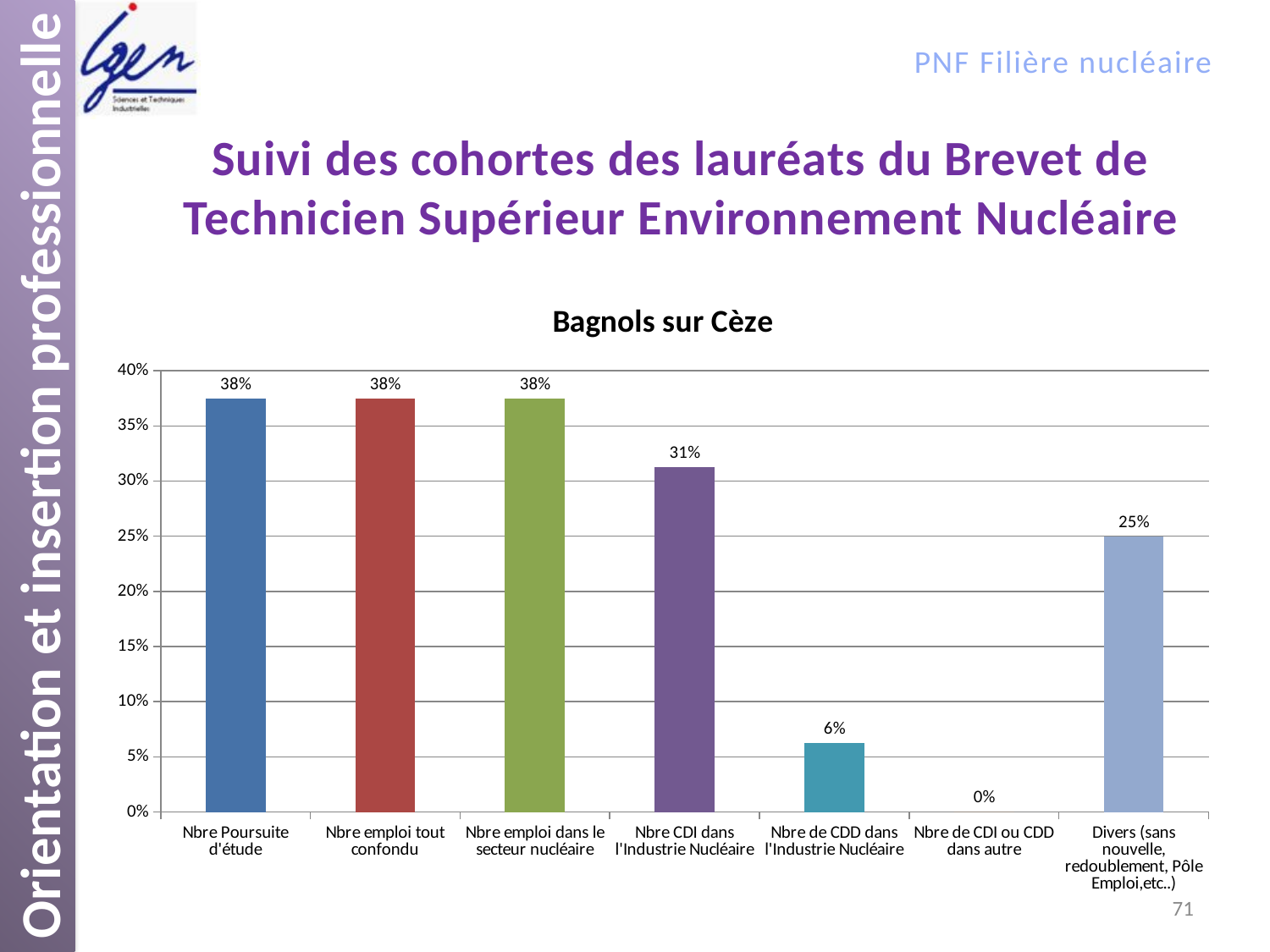
Which category has the lowest value? Nbre de CDI ou CDD dans autre Which is larger: "Nbre CDI dans l'Industrie Nucléaire" or "Divers (sans nouvelle, redoublement, Pôle Emploi,etc..)"? Nbre CDI dans l'Industrie Nucléaire What is the difference between "Divers (sans nouvelle, redoublement, Pôle Emploi,etc..)" and "Nbre de CDD dans l'Industrie Nucléaire"? 19% What is the difference between "Nbre emploi tout confondu" and "Nbre CDI dans l'Industrie Nucléaire"? 7% How many categories are shown on the x axis? 7 What kind of chart is shown? bar chart What is the value for "Divers (sans nouvelle, redoublement, Pôle Emploi,etc..)"? 25% What is the value for "Nbre CDI dans l'Industrie Nucléaire"? 31% What is the title of the chart? Bagnols sur Cèze What is the value for "Nbre Poursuite d'étude"? 38% Is the value for "Nbre emploi dans le secteur nucléaire" greater or less than 35%? greater What is the value for "Nbre de CDD dans l'Industrie Nucléaire"? 6%